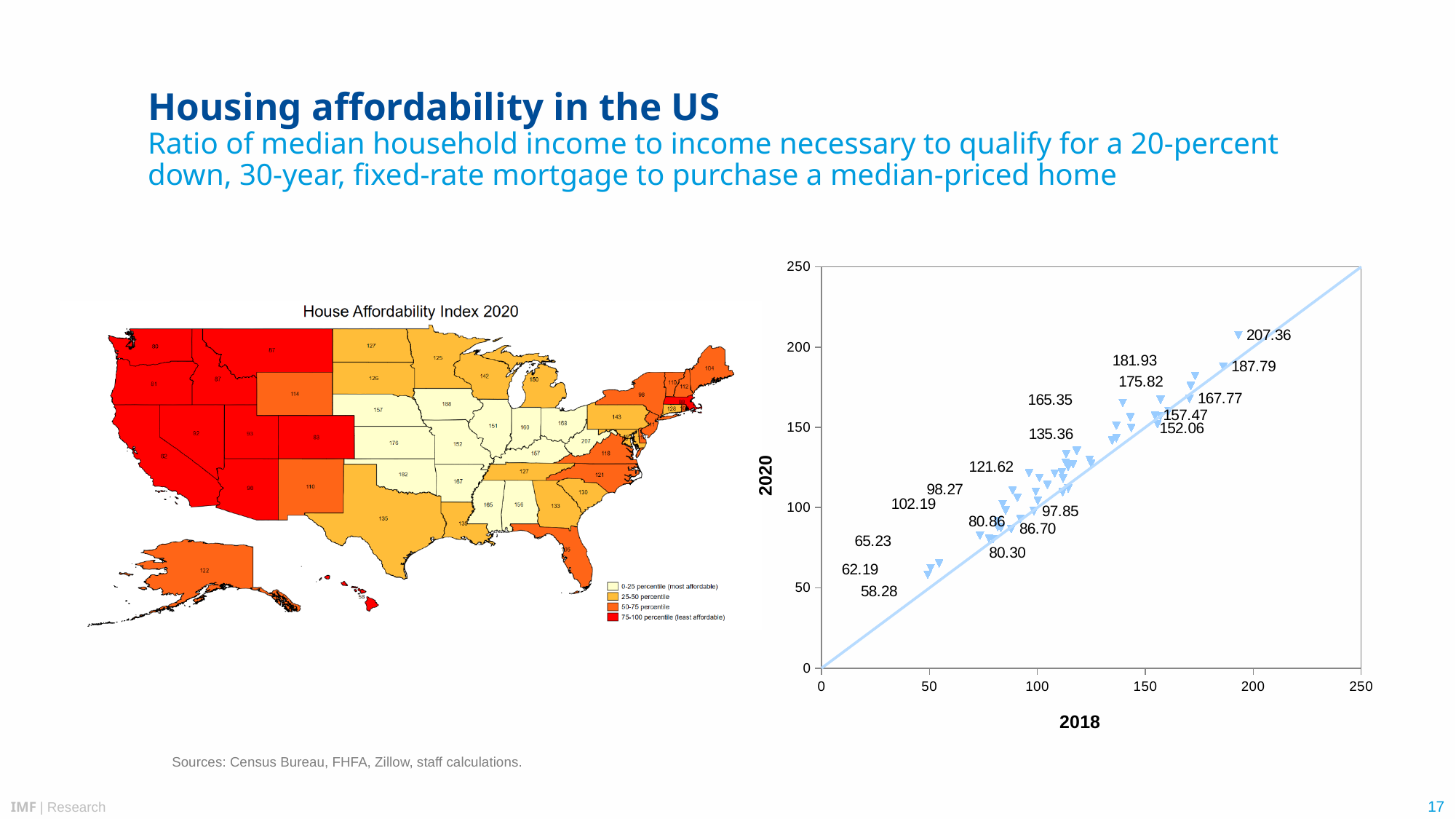
In the scatter chart on the right, what is the difference between the highest labeled value (207.36) and the lowest labeled value (58.28)? 149.08 In the scatter chart on the right, is the point labeled 207.36 greater or less than 200 on the 2020 axis? greater What kind of chart is shown on the right side of the slide? scatter chart In the map on the left, what value is shown for Alaska? 122 In the scatter chart on the right, is the point labeled 58.28 greater or less than 100 on the 2020 axis? less What is the title of the map on the left side of the slide? House Affordability Index 2020 In the scatter chart on the right, what is the maximum value shown on the 2020 axis? 250 In the scatter chart on the right, what is the lowest data label shown? 58.28 In the scatter chart on the right, what is the highest data label shown? 207.36 How many percentile categories does the legend of the map on the left list? 4 In the scatter chart on the right, which labeled value is larger, 187.79 or 181.93? 187.79 In the map on the left, what value is shown for Hawaii? 58